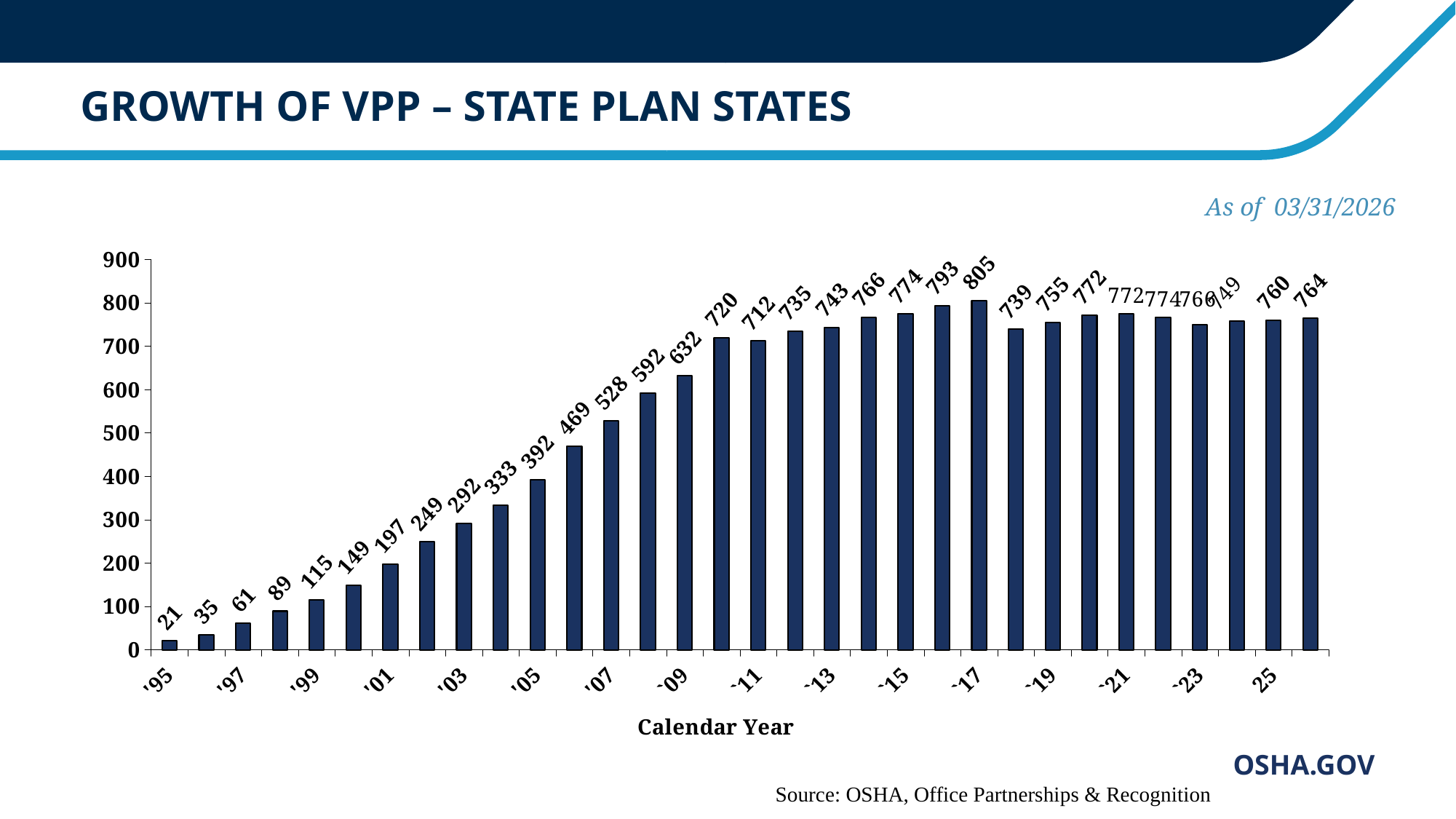
What is the value for '05? 392 What is the title of the x axis? Calendar Year Which calendar year has the highest value in the chart? '17 What is the value for '95? 21 What is the value for '17? 805 Which is larger, the value for '09 or the value for '11? '11 What is the difference between the values for '17 and '15? 31 Do the values rise or fall from '95 to '17? rise Which calendar year has the lowest value in the chart? '95 What is the value for '25? 760 What is the value for '01? 197 What kind of chart is shown on the slide? bar chart